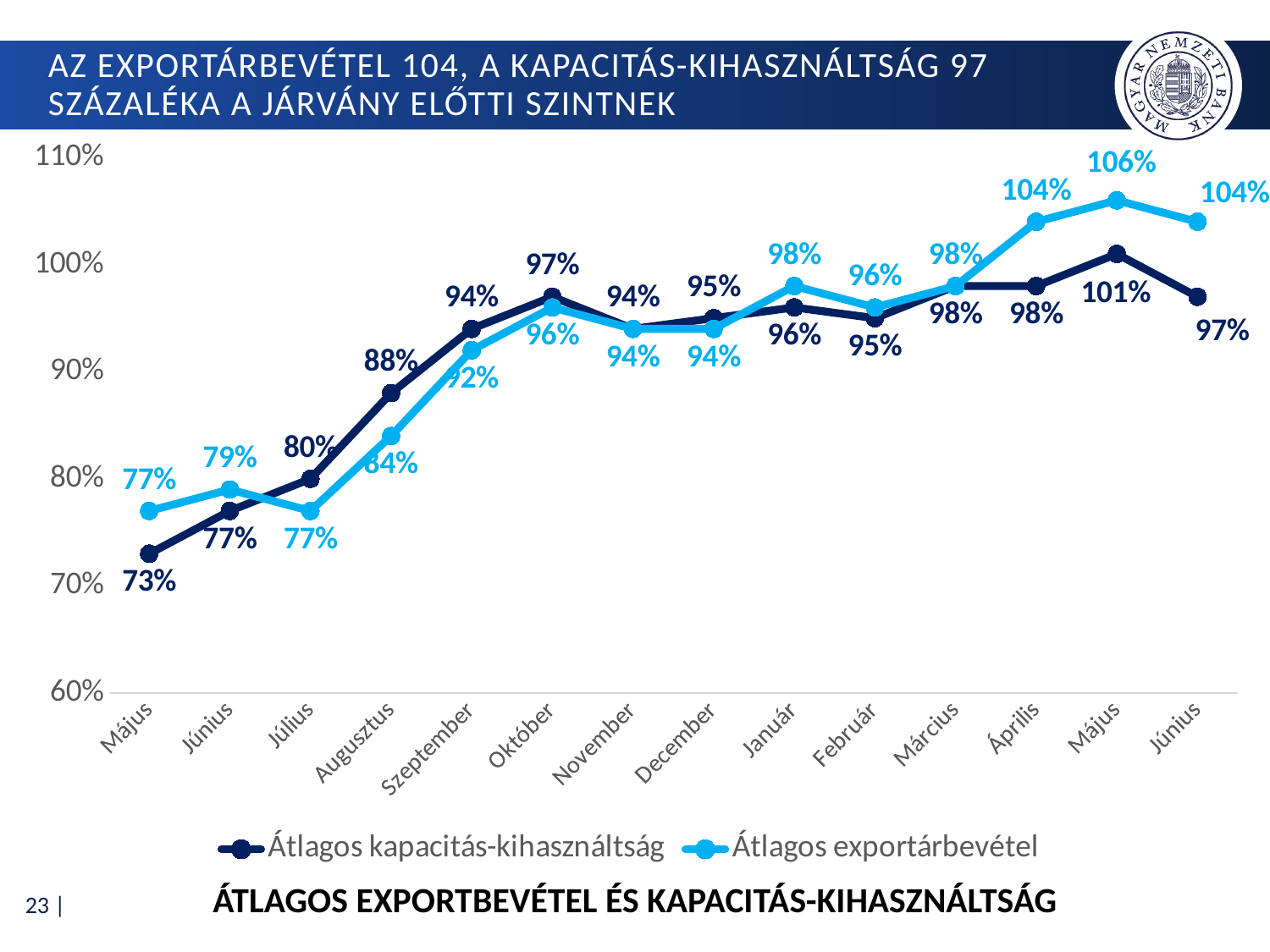
Does the Átlagos exportárbevétel series generally rise or fall from the first Május to the last Június? rise What is the value of Átlagos kapacitás-kihasználtság for the first Május on the x axis? 73% Which month has the highest value for Átlagos exportárbevétel? Május (the second one) What kind of chart is shown on the slide? line chart What is the title shown below the chart? ÁTLAGOS EXPORTBEVÉTEL ÉS KAPACITÁS-KIHASZNÁLTSÁG Which month has the lowest value for Átlagos kapacitás-kihasználtság? Május (the first one) What is the difference between Átlagos exportárbevétel and Átlagos kapacitás-kihasználtság in Április? 6% In Szeptember, which series has the larger value, Átlagos kapacitás-kihasználtság or Átlagos exportárbevétel? Átlagos kapacitás-kihasználtság How many series does the legend list? 2 What is the value of Átlagos kapacitás-kihasználtság for Október? 97% How many months are plotted along the x axis? 14 What is the value of Átlagos exportárbevétel for Augusztus? 84%